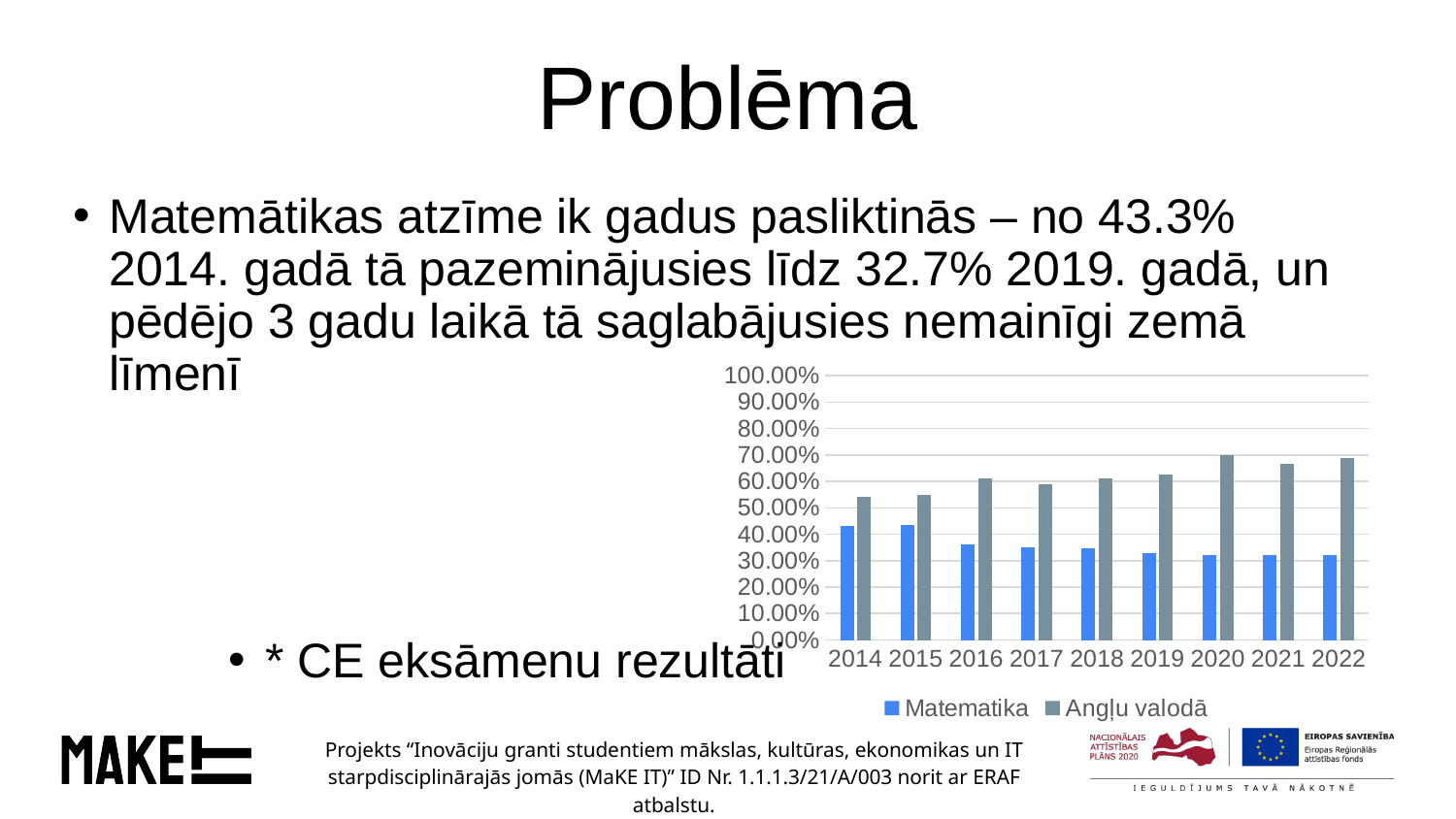
Do the Matematika values generally rise or fall from 2014 to 2022? fall Which series is shown in blue in the chart? Matematika Is the Angļu valodā value for 2014 greater or less than 60.00%? less In 2014, which series has the larger value, Matematika or Angļu valodā? Angļu valodā Is the Angļu valodā value for 2020 greater or less than 60.00%? greater Is the Matematika value for 2019 greater or less than 30.00%? greater How many years are shown on the x axis of the chart? 9 How many series does the chart legend list? 2 What kind of chart is shown on the slide? bar chart For Matematika, which year has the larger value, 2014 or 2022? 2014